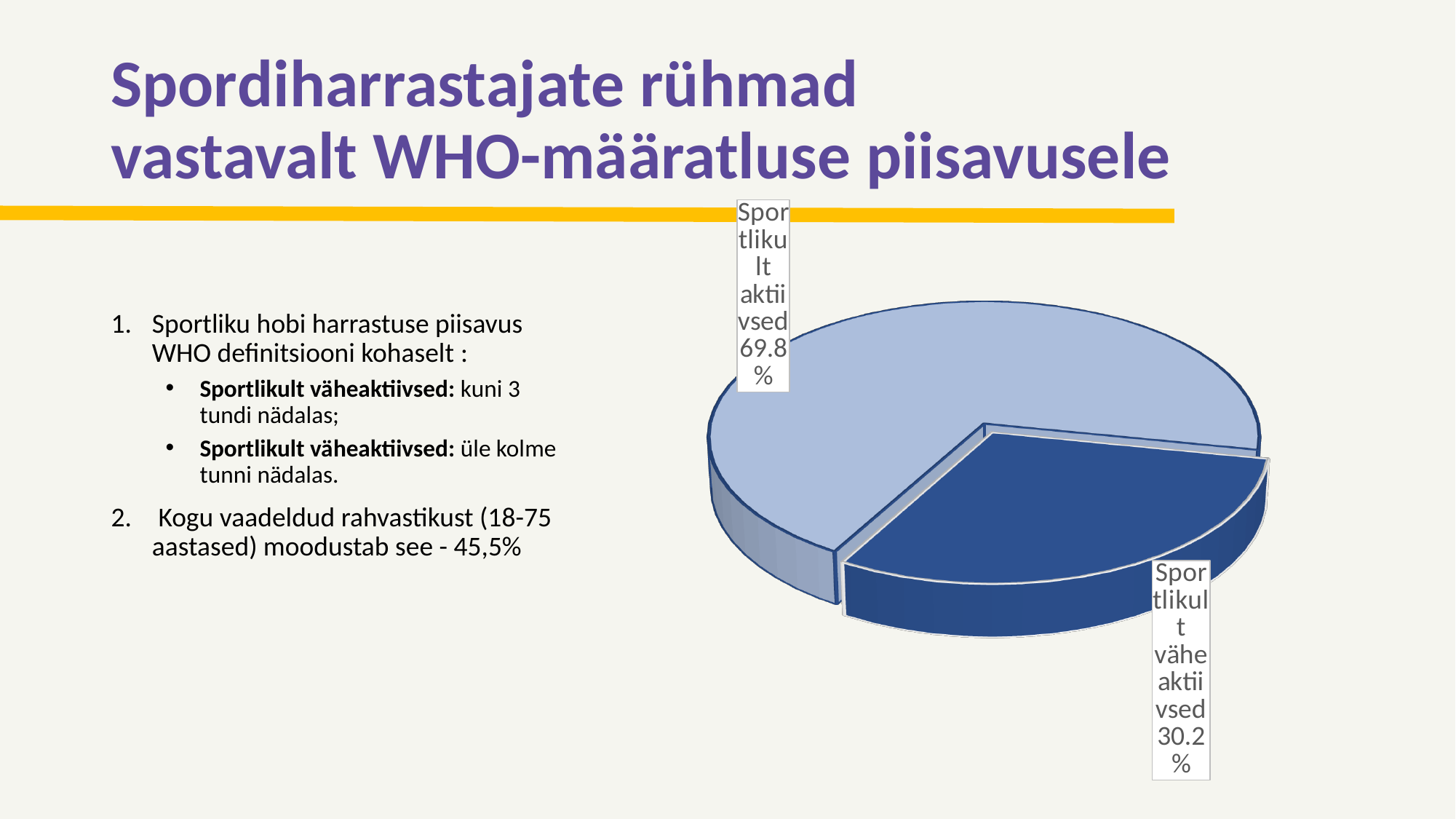
What kind of chart is shown on the slide? Pie chart Which slice of the pie chart is the smallest? Sportlikult väheaktiivsed Is the share of the "Sportlikult aktiivsed" slice greater or less than 60%? greater Which slice of the pie chart is the largest? Sportlikult aktiivsed What share of the pie does the "Sportlikult aktiivsed" slice represent? 69.8% Is the share of the "Sportlikult väheaktiivsed" slice greater or less than 50%? less How many slices does the pie chart have? 2 What is the difference in percentage points between the "Sportlikult aktiivsed" and "Sportlikult väheaktiivsed" slices? 39.6 Which slice of the pie chart is drawn in the darker blue colour? Sportlikult väheaktiivsed Which slice of the pie chart is pulled out (exploded) from the rest of the pie? Sportlikult väheaktiivsed What share of the pie does the "Sportlikult väheaktiivsed" slice represent? 30.2% Which is larger: the "Sportlikult aktiivsed" slice or the "Sportlikult väheaktiivsed" slice? Sportlikult aktiivsed